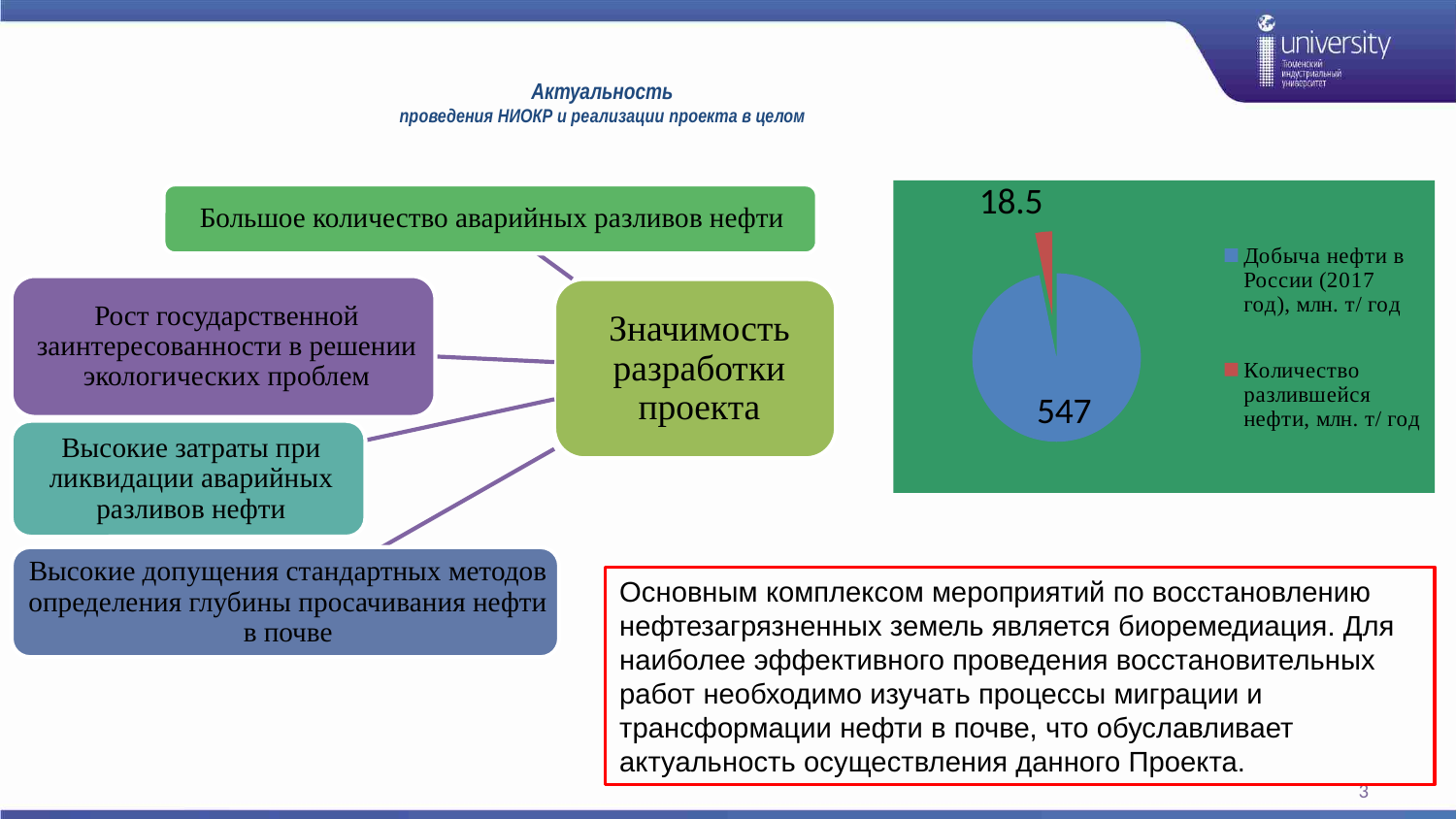
What colour is the slice for "Добыча нефти в России (2017 год), млн. т/ год" in the pie chart? blue What is the value for "Добыча нефти в России (2017 год), млн. т/ год" in the pie chart? 547 What type of chart is shown on the slide? pie chart What is the difference between the oil production value and the spilled oil value in the pie chart? 528.5 What colour is the slice for "Количество разлившейся нефти, млн. т/ год" in the pie chart? red How many entries does the legend of the pie chart list? 2 Which slice of the pie chart is the smallest? Количество разлившейся нефти, млн. т/ год Which is larger in the pie chart: oil production in Russia or the amount of spilled oil? Добыча нефти в России (2017 год), млн. т/ год What is the value for "Количество разлившейся нефти, млн. т/ год" in the pie chart? 18.5 How many slices does the pie chart have? 2 Which slice of the pie chart is the largest? Добыча нефти в России (2017 год), млн. т/ год What is the total of the two values shown in the pie chart? 565.5